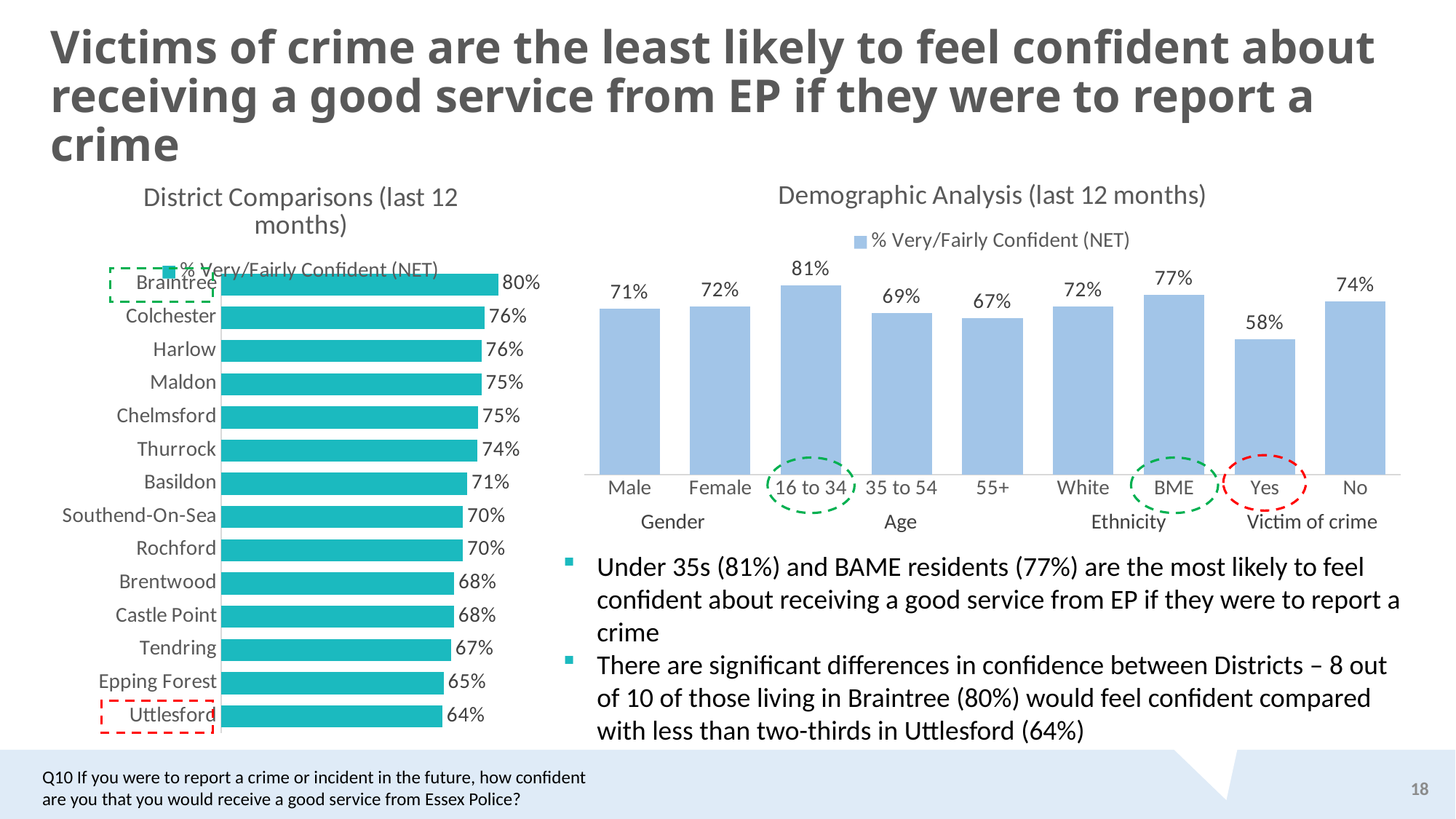
In the Demographic Analysis chart, how many categories are plotted? 9 What type of chart is the District Comparisons chart? Bar chart In the District Comparisons chart, what is the difference between Braintree and Uttlesford? 16% In the Demographic Analysis chart, what is the value for BME? 77% In the District Comparisons chart, how many districts are shown? 14 In the District Comparisons chart, which district has the lowest value? Uttlesford In the Demographic Analysis chart, what is the difference between the Yes and No categories under Victim of crime? 16% In the District Comparisons chart, what is the value for Braintree? 80% In the Demographic Analysis chart, which is larger, the value for Male or the value for Female? Female In the District Comparisons chart, what is the value for Thurrock? 74% In the Demographic Analysis chart, which category has the highest value? 16 to 34 In the Demographic Analysis chart, which category has the lowest value? Yes